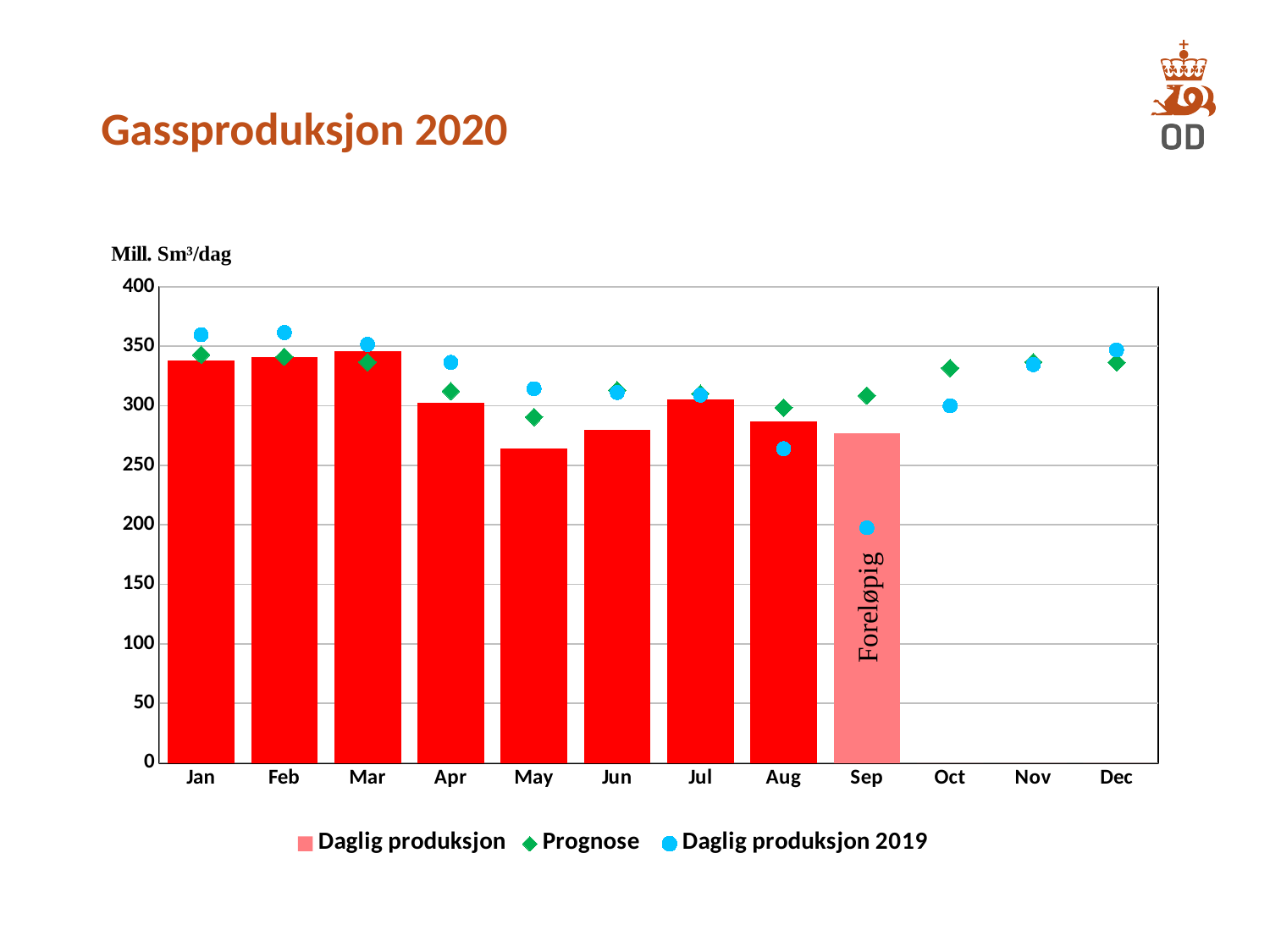
What label is written on the Sep bar? Foreløpig How many months are labelled on the x axis? 12 Do the Daglig produksjon bars rise or fall from Mar to May? fall Is the Daglig produksjon value for Mar greater or less than 300? greater What kind of chart is shown on the slide? bar chart How many series does the legend list? 3 Which is larger, the Daglig produksjon bar for Jan or for May? Jan Is the Daglig produksjon value for May greater or less than 300? less How many months have a Daglig produksjon bar? 9 Is the Daglig produksjon 2019 value for Sep greater or less than 250? less Which month has the lowest Daglig produksjon bar? May